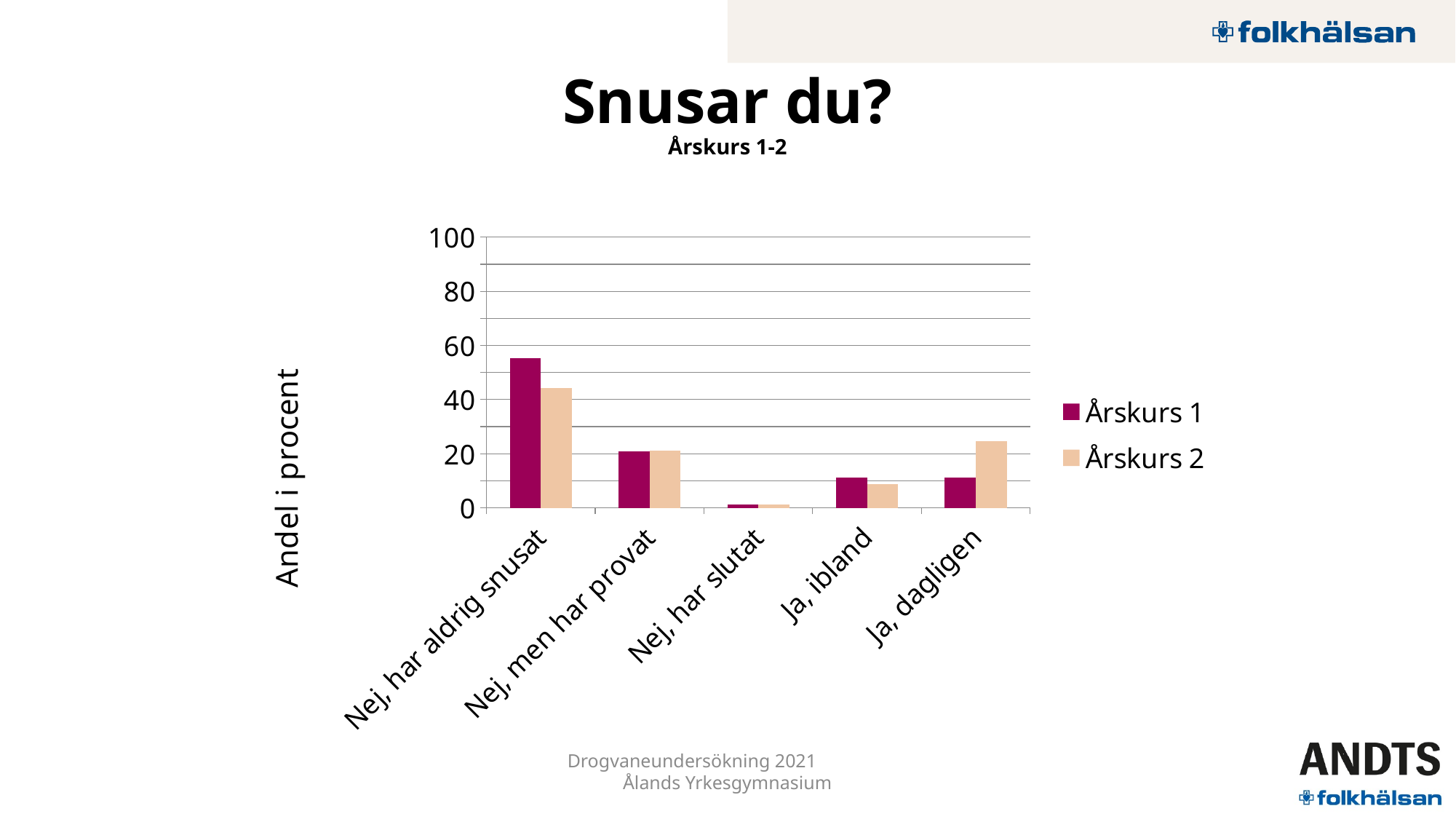
Is the value for Årskurs 2 in 'Ja, dagligen' greater or less than 20? greater How many categories are shown on the x axis? 5 Which category has the highest value for Årskurs 1? Nej, har aldrig snusat For 'Nej, har aldrig snusat', which series has the larger value, Årskurs 1 or Årskurs 2? Årskurs 1 What is the label of the y axis? Andel i procent How many series does the legend list? 2 For 'Ja, dagligen', which series has the larger value, Årskurs 1 or Årskurs 2? Årskurs 2 Is the value for Årskurs 1 in 'Nej, men har provat' greater or less than 40? less Which category has the highest value for Årskurs 2? Nej, har aldrig snusat Is the value for Årskurs 1 in 'Nej, har aldrig snusat' greater or less than 40? greater Which category has the lowest value for Årskurs 2? Nej, har slutat What kind of chart is shown on the slide? bar chart